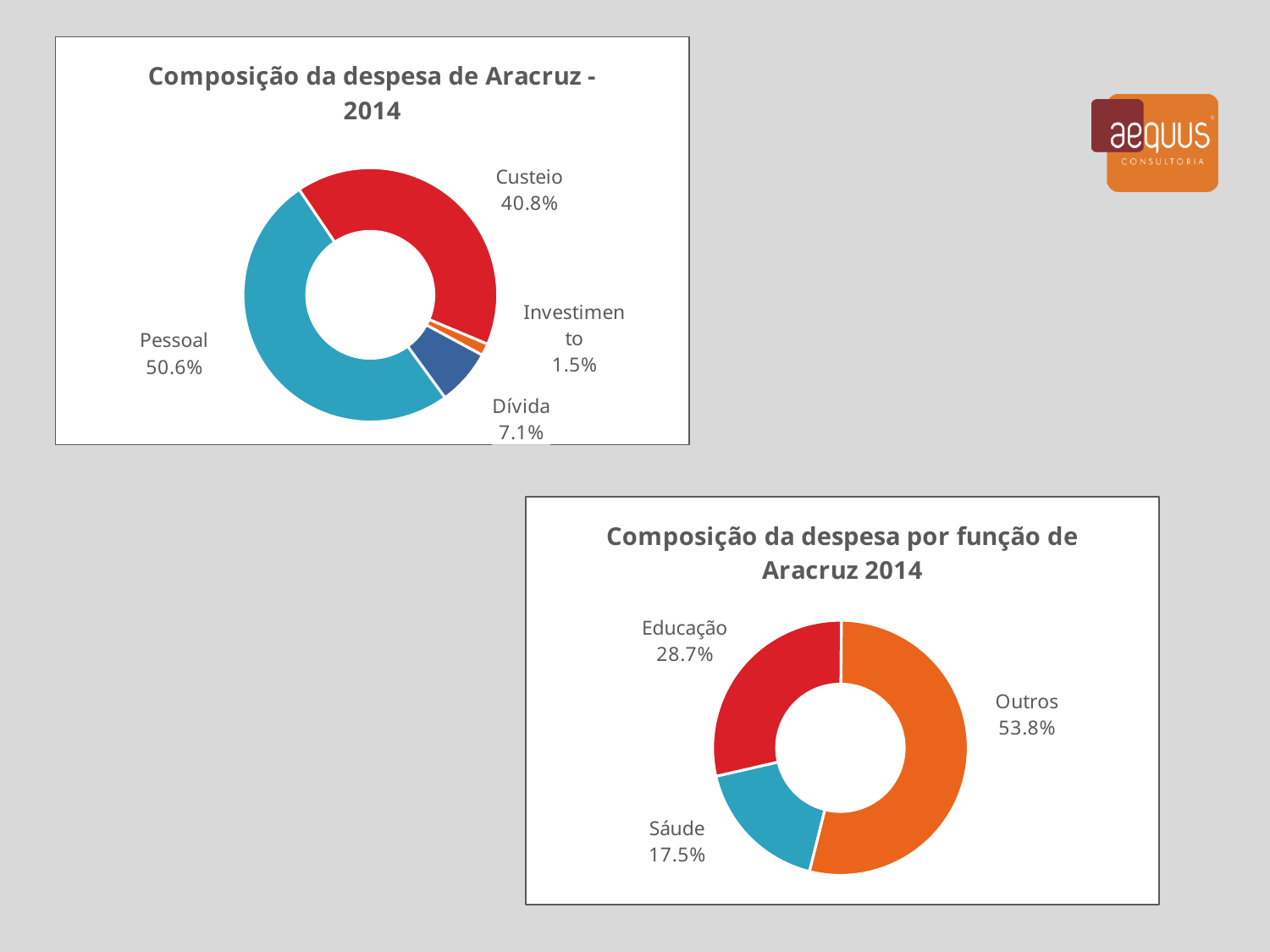
In the chart 'Composição da despesa por função de Aracruz 2014', what is the difference between the shares of Outros and Educação? 25.1% In the chart 'Composição da despesa de Aracruz - 2014', how many categories are shown? 4 In the chart 'Composição da despesa por função de Aracruz 2014', which is larger, Educação or Sáude? Educação In the chart 'Composição da despesa por função de Aracruz 2014', what share does Sáude have? 17.5% In the chart 'Composição da despesa por função de Aracruz 2014', what share does Outros have? 53.8% In the chart 'Composição da despesa de Aracruz - 2014', what is the difference between the shares of Pessoal and Custeio? 9.8% In the chart 'Composição da despesa de Aracruz - 2014', which category has the smallest share? Investimento In the chart 'Composição da despesa por função de Aracruz 2014', how many categories are shown? 3 In the chart 'Composição da despesa de Aracruz - 2014', what share does Pessoal have? 50.6% What kind of chart is 'Composição da despesa de Aracruz - 2014'? Doughnut (pie) chart In the chart 'Composição da despesa de Aracruz - 2014', what share does Custeio have? 40.8% In the chart 'Composição da despesa de Aracruz - 2014', which category has the largest share? Pessoal